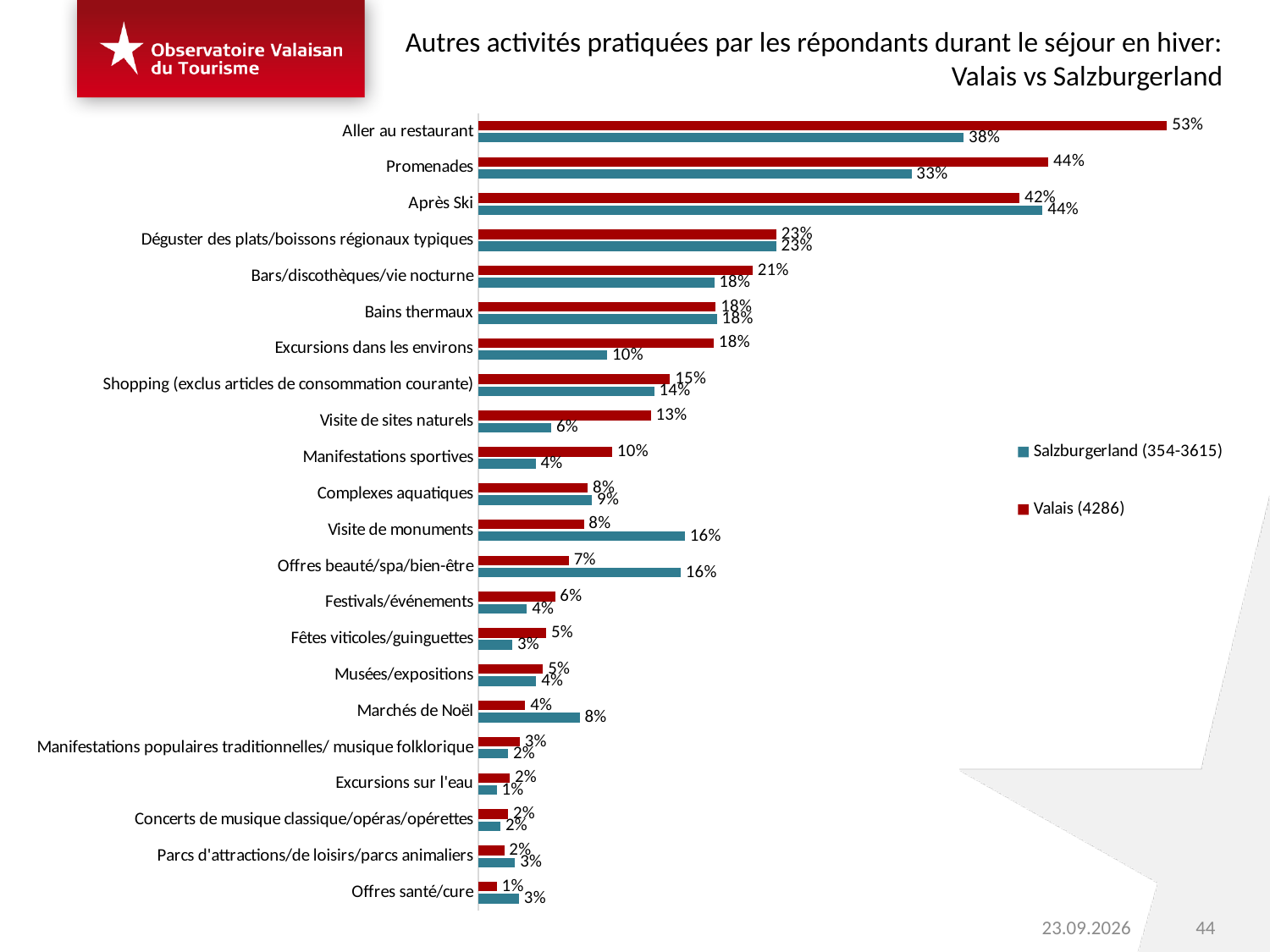
Which activity has the highest value for Valais? Aller au restaurant What is the difference between the Valais and Salzburgerland values for 'Aller au restaurant'? 15% What percentage of Valais respondents reported 'Aller au restaurant'? 53% How many activity categories are shown on the chart? 22 What is the difference between the Valais and Salzburgerland values for 'Offres beauté/spa/bien-être'? 9% Which activity has the highest value for Salzburgerland? Après Ski What is the Salzburgerland value for 'Promenades'? 33% What type of chart is shown on the slide? Bar chart What is the Salzburgerland value for 'Visite de monuments'? 16% How many series does the legend list? 2 For 'Marchés de Noël', which is larger: the Valais value or the Salzburgerland value? Salzburgerland For 'Excursions dans les environs', which is larger: the Valais value or the Salzburgerland value? Valais